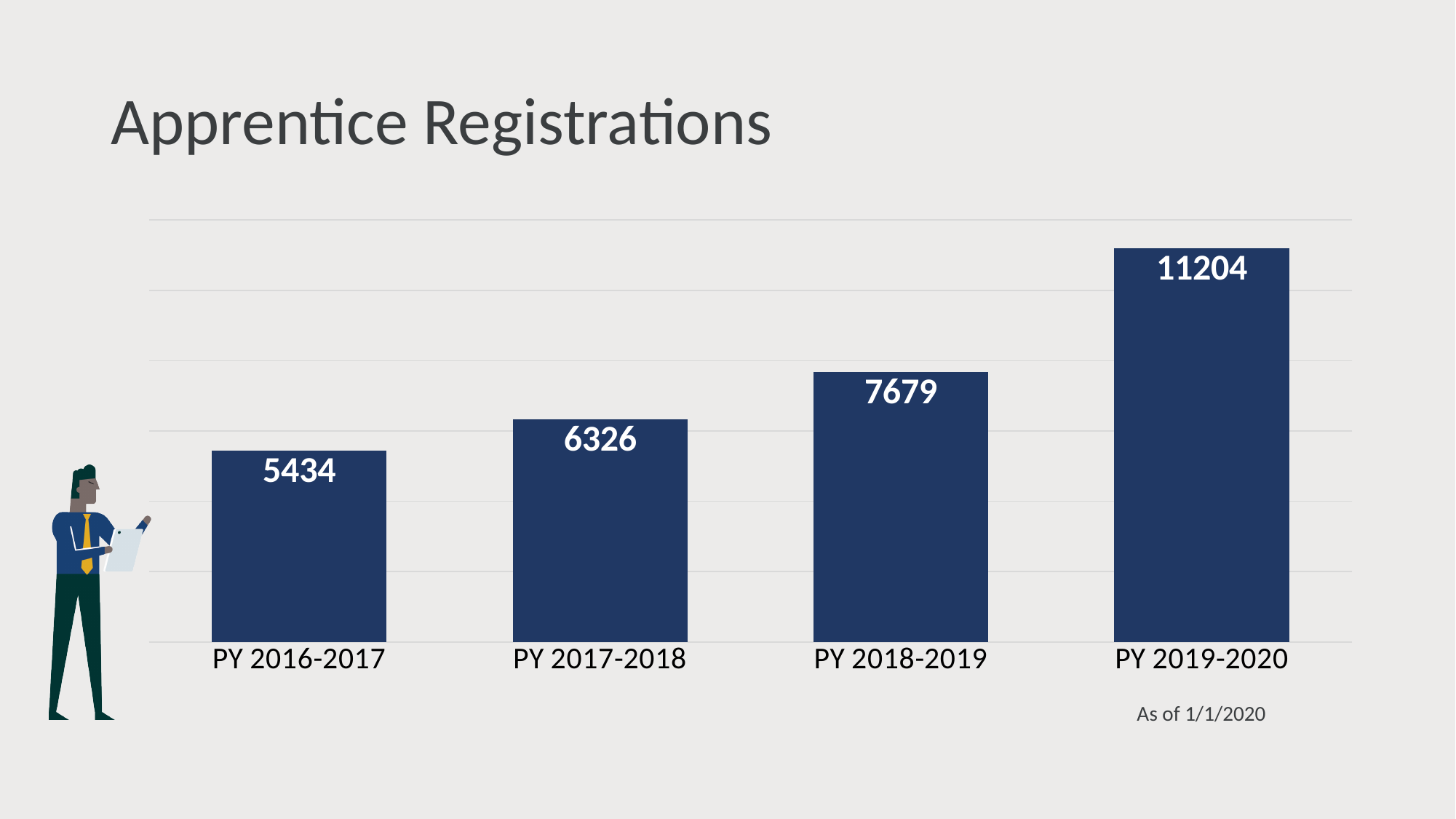
What is the value for PY 2019-2020? 11204 Which program year has the highest number of apprentice registrations? PY 2019-2020 What is the difference between the values for PY 2019-2020 and PY 2018-2019? 3525 What is the difference between the values for PY 2017-2018 and PY 2016-2017? 892 What is the value for PY 2018-2019? 7679 How many program years are shown in the chart? 4 What is the value for PY 2017-2018? 6326 What kind of chart is shown on the slide? Bar chart Which is larger, the value for PY 2018-2019 or the value for PY 2017-2018? PY 2018-2019 What is the value for PY 2016-2017? 5434 Which program year has the lowest number of apprentice registrations? PY 2016-2017 Do the values rise or fall from PY 2016-2017 to PY 2019-2020? Rise